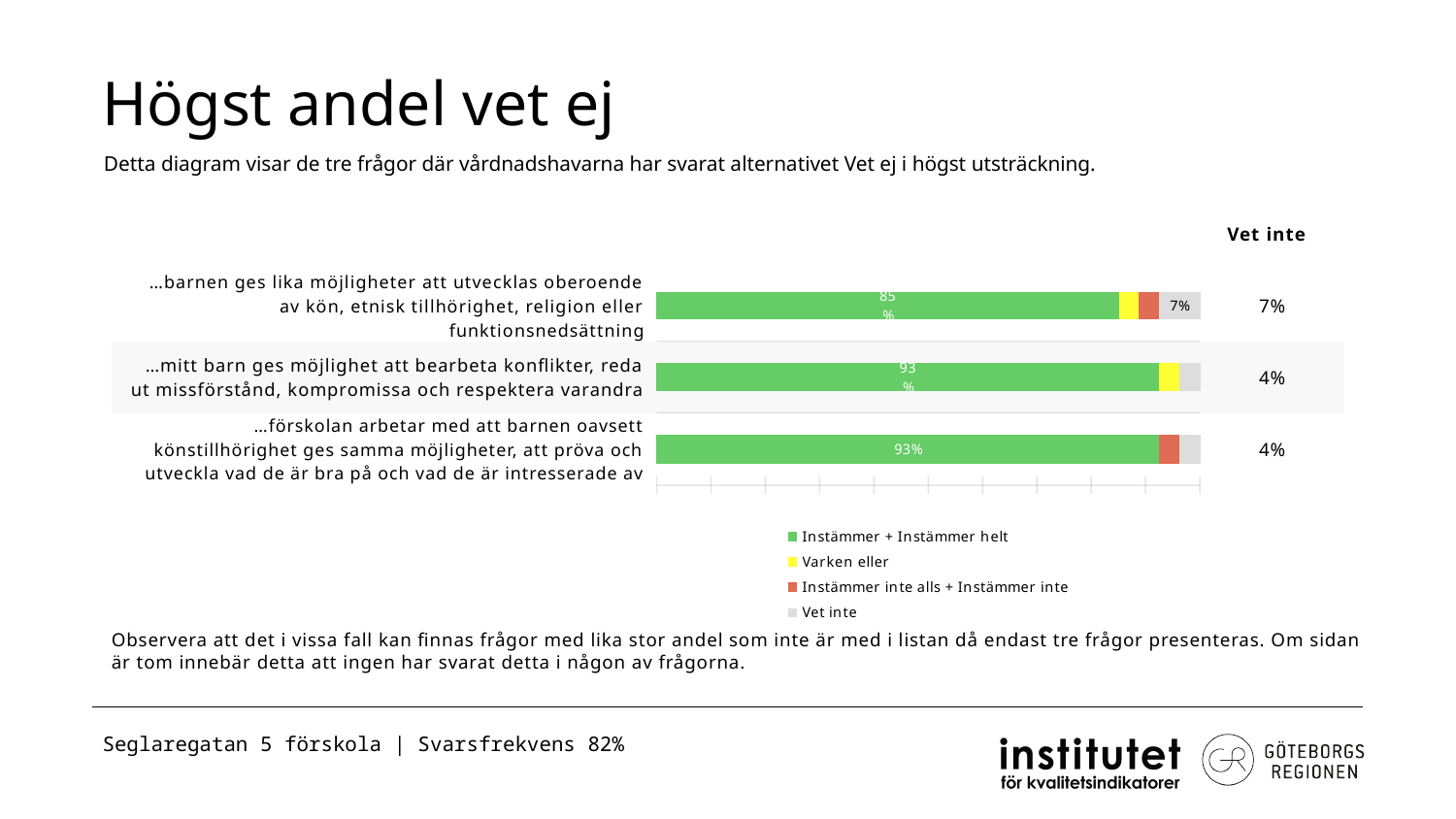
How many questions (categories) are plotted in the chart? 3 How many series does the chart legend list? 4 Which question has the lowest Instämmer + Instämmer helt share? …barnen ges lika möjligheter att utvecklas oberoende av kön, etnisk tillhörighet, religion eller funktionsnedsättning What colour represents Instämmer + Instämmer helt in the chart legend? Green Which question has the highest Vet inte share? …barnen ges lika möjligheter att utvecklas oberoende av kön, etnisk tillhörighet, religion eller funktionsnedsättning What kind of chart is shown on the slide? Bar chart What is the Vet inte value for the question beginning "…barnen ges lika möjligheter att utvecklas oberoende av kön…"? 7% What is the difference in Instämmer + Instämmer helt share between the question beginning "…mitt barn ges möjlighet att bearbeta konflikter…" and the question beginning "…barnen ges lika möjligheter…"? 8 percentage points What is the Vet inte value for the question beginning "…förskolan arbetar med att barnen oavsett könstillhörighet…"? 4% What is the Instämmer + Instämmer helt value for the question beginning "…mitt barn ges möjlighet att bearbeta konflikter…"? 93% What is the Instämmer + Instämmer helt value for the question beginning "…barnen ges lika möjligheter att utvecklas oberoende av kön…"? 85% Which has the larger Vet inte share: the question beginning "…barnen ges lika möjligheter…" or the question beginning "…mitt barn ges möjlighet att bearbeta konflikter…"? …barnen ges lika möjligheter…